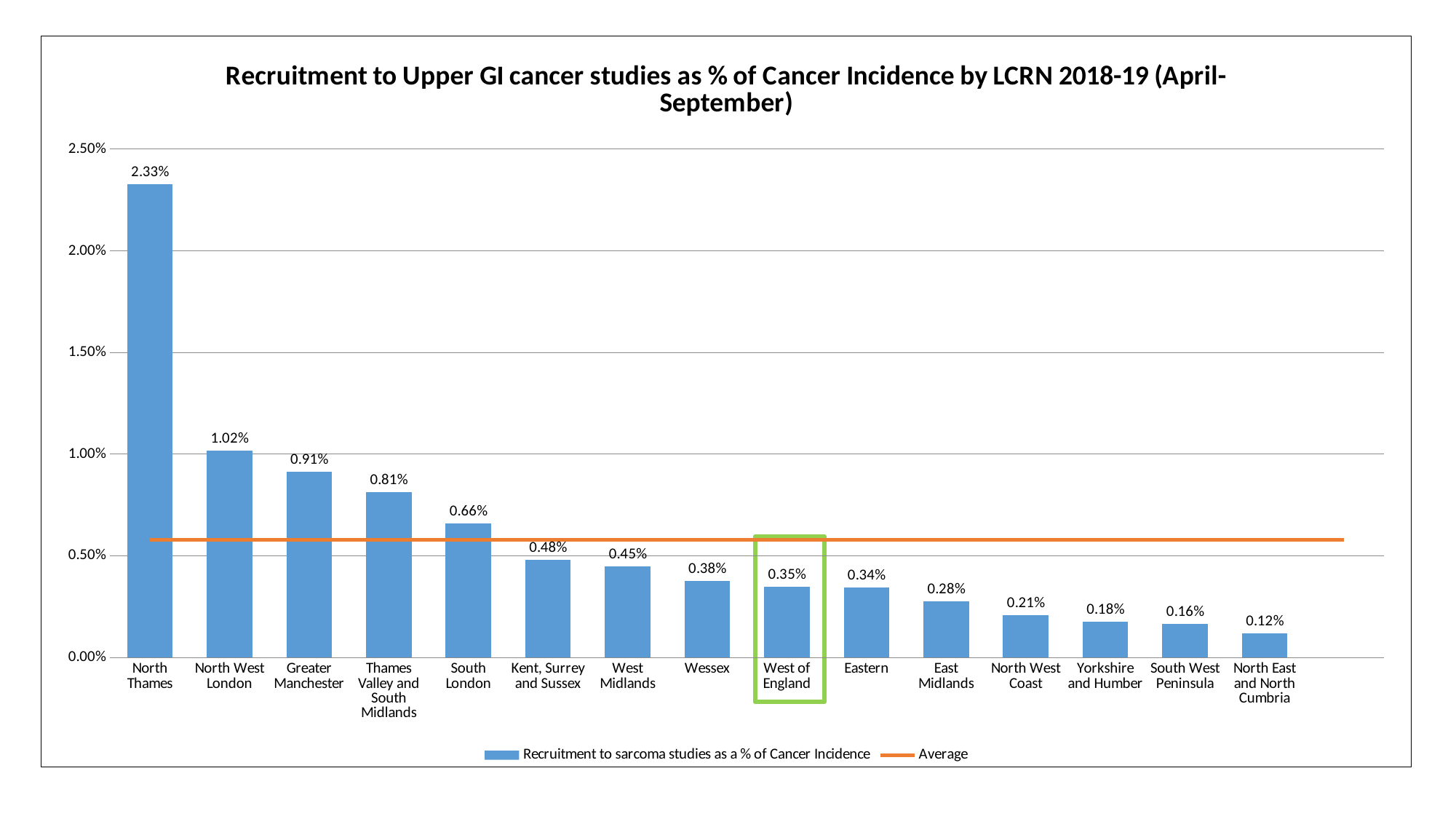
What is the value for Greater Manchester? 0.91% What is the value for North Thames? 2.33% Which is larger, the value for Wessex or the value for Eastern? Wessex What kind of chart is this? bar chart Do the bar values rise or fall from left to right along the x axis? fall What is the difference between the values for North West London and South London? 0.36% How many LCRNs are shown on the x axis? 15 Which LCRN has the highest recruitment percentage? North Thames How many entries does the legend list? 2 Which LCRN has the lowest recruitment percentage? North East and North Cumbria Is the value for Thames Valley and South Midlands greater or less than 1.00%? less What is the value for West of England? 0.35%